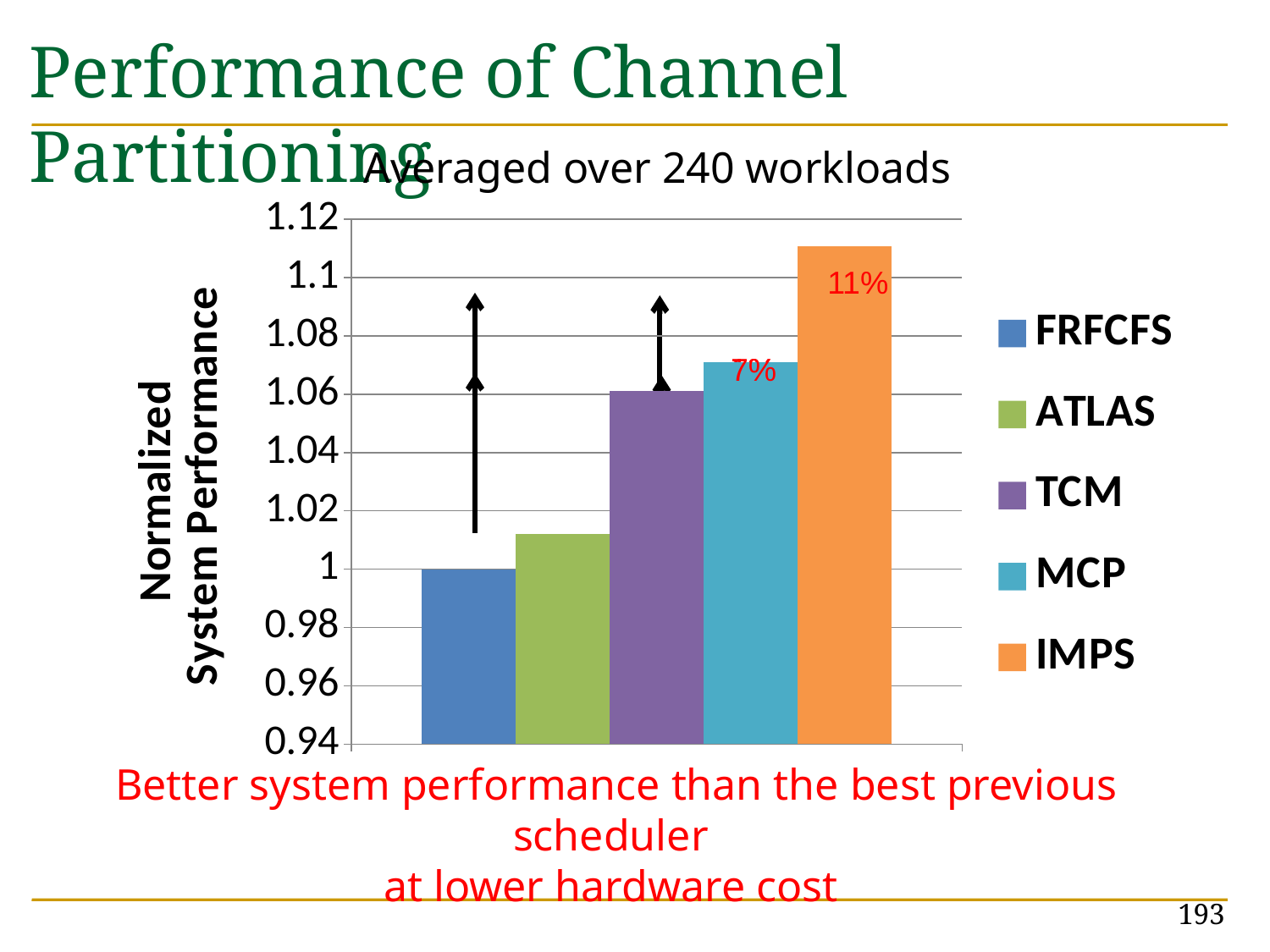
How many bars are plotted in the chart? 5 Is the value for ATLAS greater or less than 1.02? less What kind of chart is shown on the slide? bar chart What is the normalized system performance value for FRFCFS? 1 What is the title of the chart? Averaged over 240 workloads Which has a higher normalized system performance, TCM or ATLAS? TCM Do the bar values rise or fall from left to right across the chart? rise Is the value for TCM greater or less than 1.04? greater Which scheduler has the highest normalized system performance? IMPS How many series does the legend list? 5 Which scheduler has the lowest normalized system performance? FRFCFS Is the value for IMPS greater or less than 1.1? greater